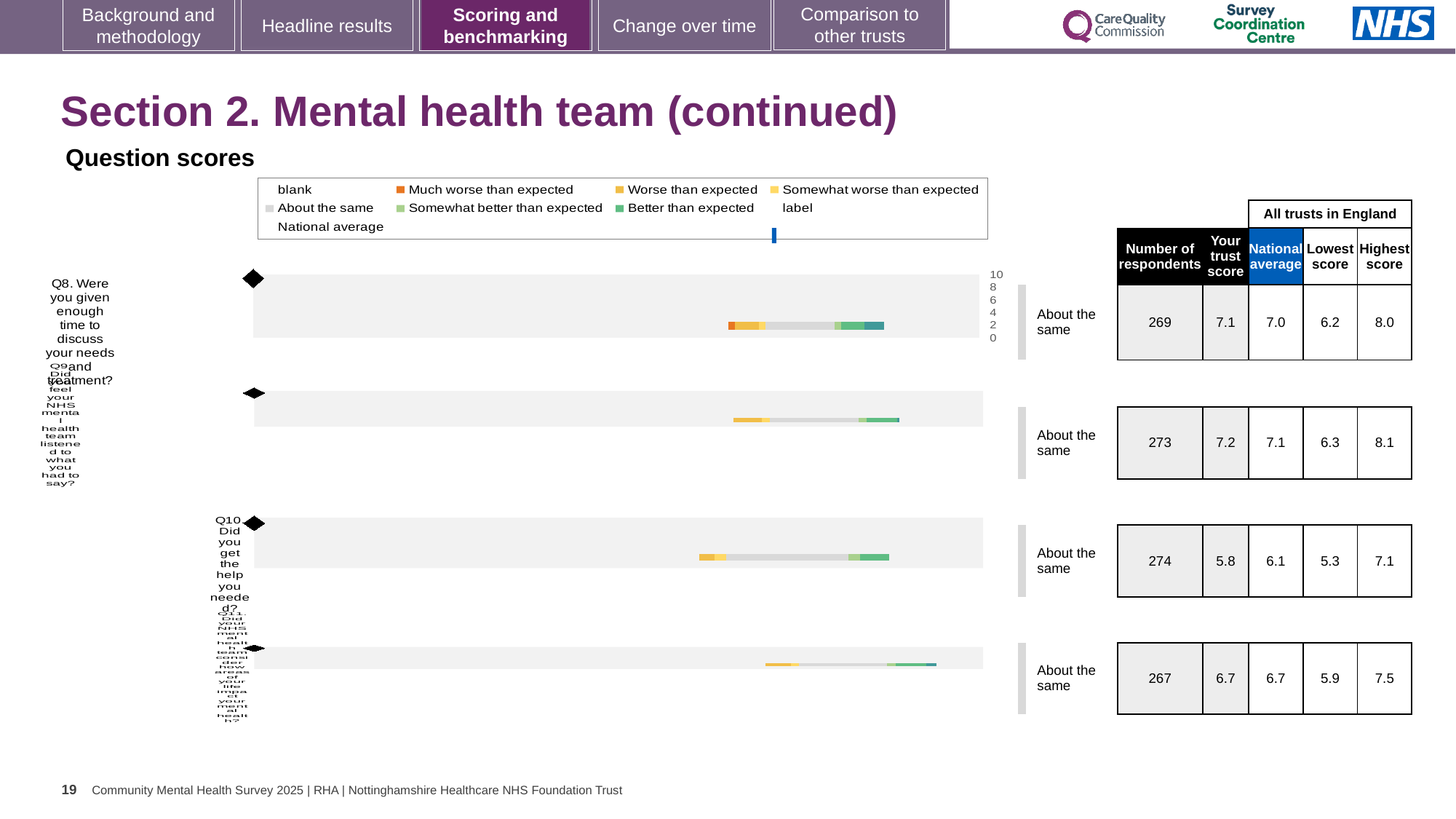
In the chart legend, what colour represents 'About the same'? grey How many question charts are shown on the slide? 4 In the chart legend, what colour represents 'Much worse than expected'? orange What is the highest tick value shown on the chart axis? 10 What kind of chart is used for the Q8 question score? bar chart Which question is plotted in the top chart on the slide? Q8. Were you given enough time to discuss your needs and treatment?